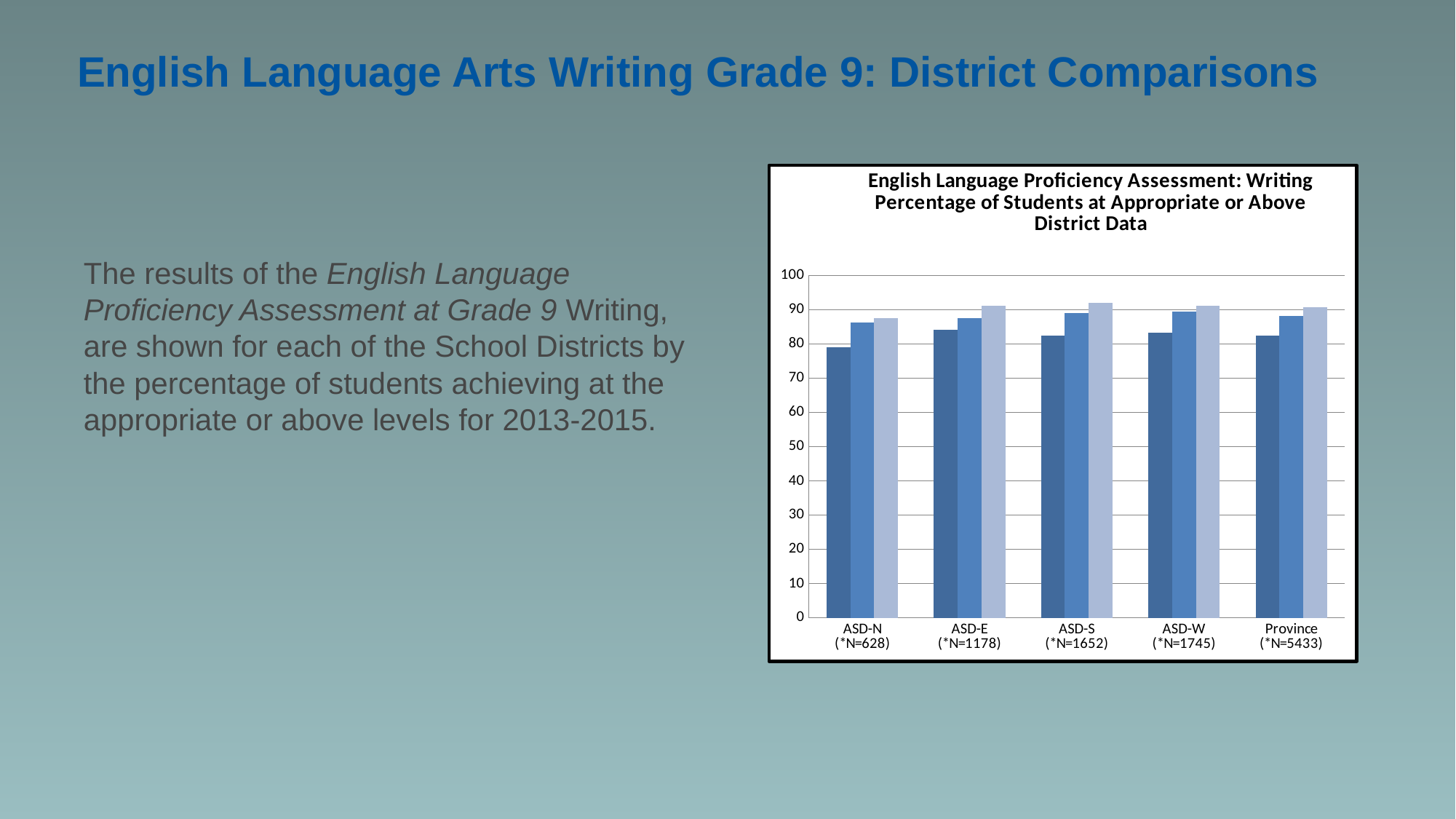
What is the sample size (N) shown for the Province category? *N=5433 Within each category, do the three bars rise or fall from left to right? rise How many districts/categories are shown on the x axis of the chart? 5 Is the value of the lightest (rightmost) bar for ASD-N greater or less than 90? less How many bars are plotted for each category in the chart? 3 Which category has the lowest value for its darkest (leftmost) bar? ASD-N What kind of chart is shown on the slide? bar chart Which is larger: the darkest (leftmost) bar for ASD-N or the darkest (leftmost) bar for ASD-E? ASD-E Is the value of the darkest (leftmost) bar for ASD-E greater or less than 80? greater Is the value of the lightest (rightmost) bar for ASD-S greater or less than 90? greater